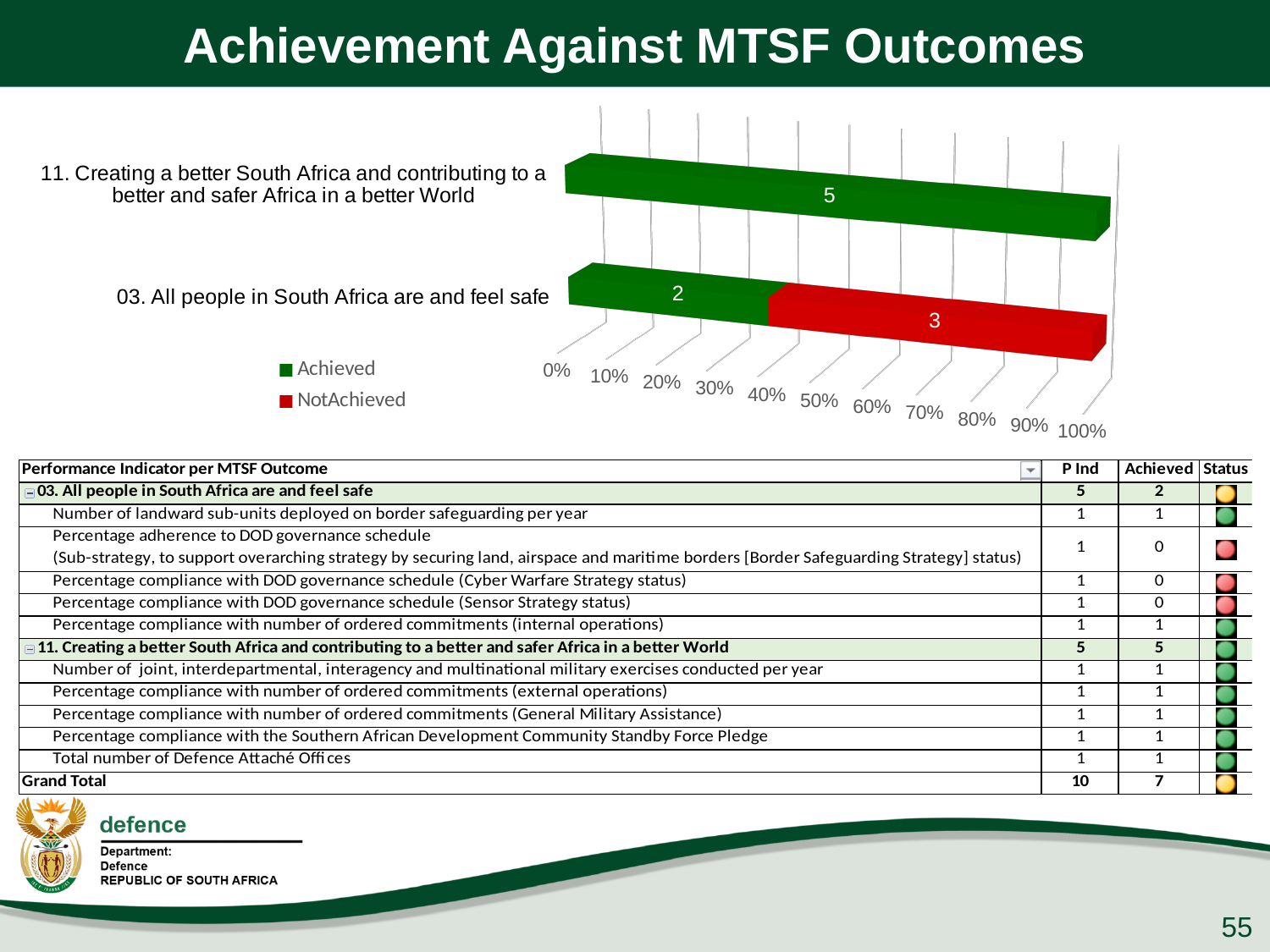
Which colour represents the NotAchieved series in the chart? red Which outcome has the higher Achieved value, outcome 03 or outcome 11? 11. Creating a better South Africa and contributing to a better and safer Africa in a better World How many series does the chart legend list? 2 How many outcome categories are plotted in the chart? 2 What type of chart is shown on the slide? bar chart What is the NotAchieved value for outcome 03 (All people in South Africa are and feel safe)? 3 What is the total of the stacked bar for outcome 03 (All people in South Africa are and feel safe)? 5 For outcome 03, which is larger, the Achieved or the NotAchieved value? NotAchieved What is the difference between the Achieved values for outcome 11 and outcome 03? 3 What is the Achieved value for outcome 03 (All people in South Africa are and feel safe)? 2 Is the Achieved segment for outcome 03 greater or less than 50% of the bar? less What is the Achieved value for outcome 11 (Creating a better South Africa and contributing to a better and safer Africa in a better World)? 5